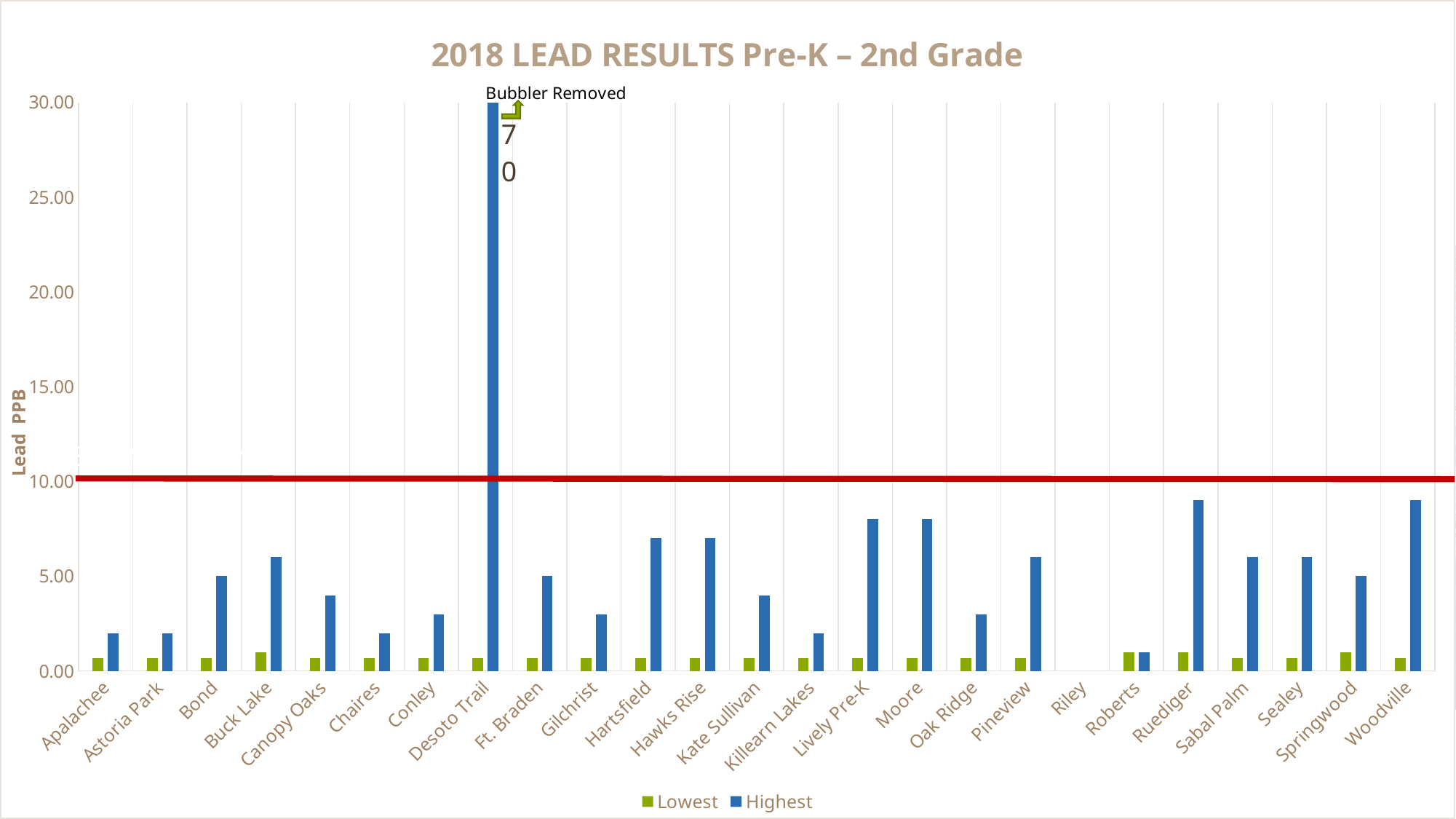
Is the 'Highest' value for Apalachee greater or less than 5.00? less Is the 'Highest' value for Woodville greater or less than 10.00? less What is the title of the chart? 2018 LEAD RESULTS Pre-K – 2nd Grade What is the 'Highest' lead value for Bond in PPB? 5.00 Which has a larger 'Highest' value, Buck Lake or Apalachee? Buck Lake How many schools (categories) are shown on the x axis? 25 How many series does the legend list? 2 Is the 'Highest' value for Ruediger greater or less than 5.00? greater What kind of chart is shown on the slide? Bar chart Which school has the highest 'Highest' lead value? Desoto Trail What is the 'Highest' lead value for Ft. Braden in PPB? 5.00 What annotation text appears above the Desoto Trail bar? Bubbler Removed